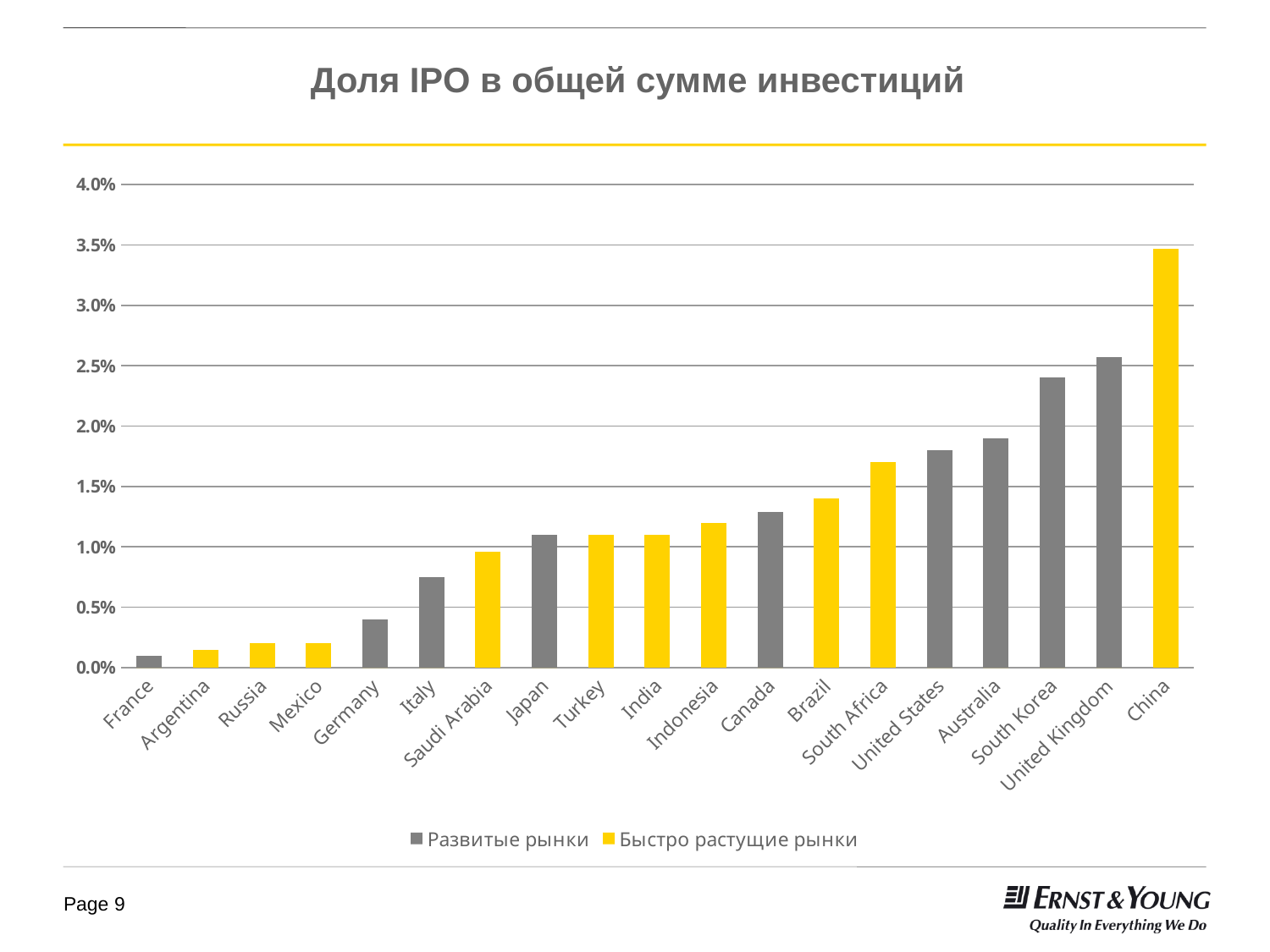
Is the value for China greater or less than 3.0%? greater Is the value for Germany greater or less than 0.5%? less Is the value for Brazil greater or less than 1.5%? less How many series does the legend list? 2 What kind of chart is shown on the slide? bar chart Do the values rise or fall moving from left to right along the x axis? rise Which country has the highest share of IPO in total investments? China How many countries are shown on the x axis? 19 What is the title of the chart? Доля IPO в общей сумме инвестиций Which is larger, the value for United Kingdom or the value for South Africa? United Kingdom Which country has the lowest share of IPO in total investments? France